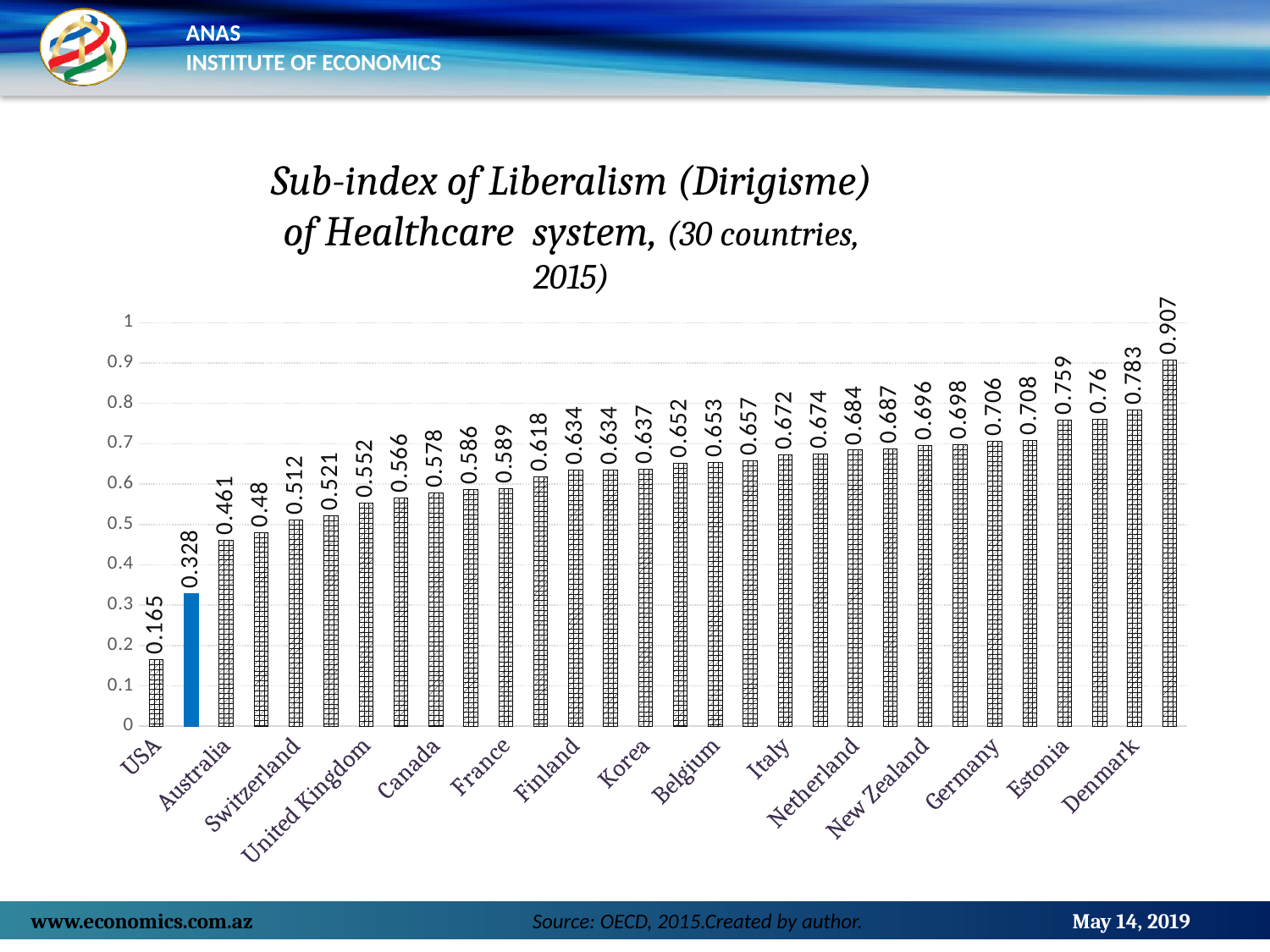
Which country has the lowest value in the chart? USA What is the highest value shown in the chart? 0.907 Which has a larger value, USA or Denmark? Denmark What is the difference between the highest value (0.907) and the lowest value (0.165)? 0.742 What is the difference between the second bar (0.328) and the first bar (0.165)? 0.163 What is the value of the highlighted blue bar (the second bar)? 0.328 What is the value for USA? 0.165 How many countries are included in the chart? 30 What type of chart is shown on the slide? bar chart Is the value for USA greater or less than 0.2? less Do the values rise or fall from left to right along the x axis? rise What year does the chart title refer to? 2015